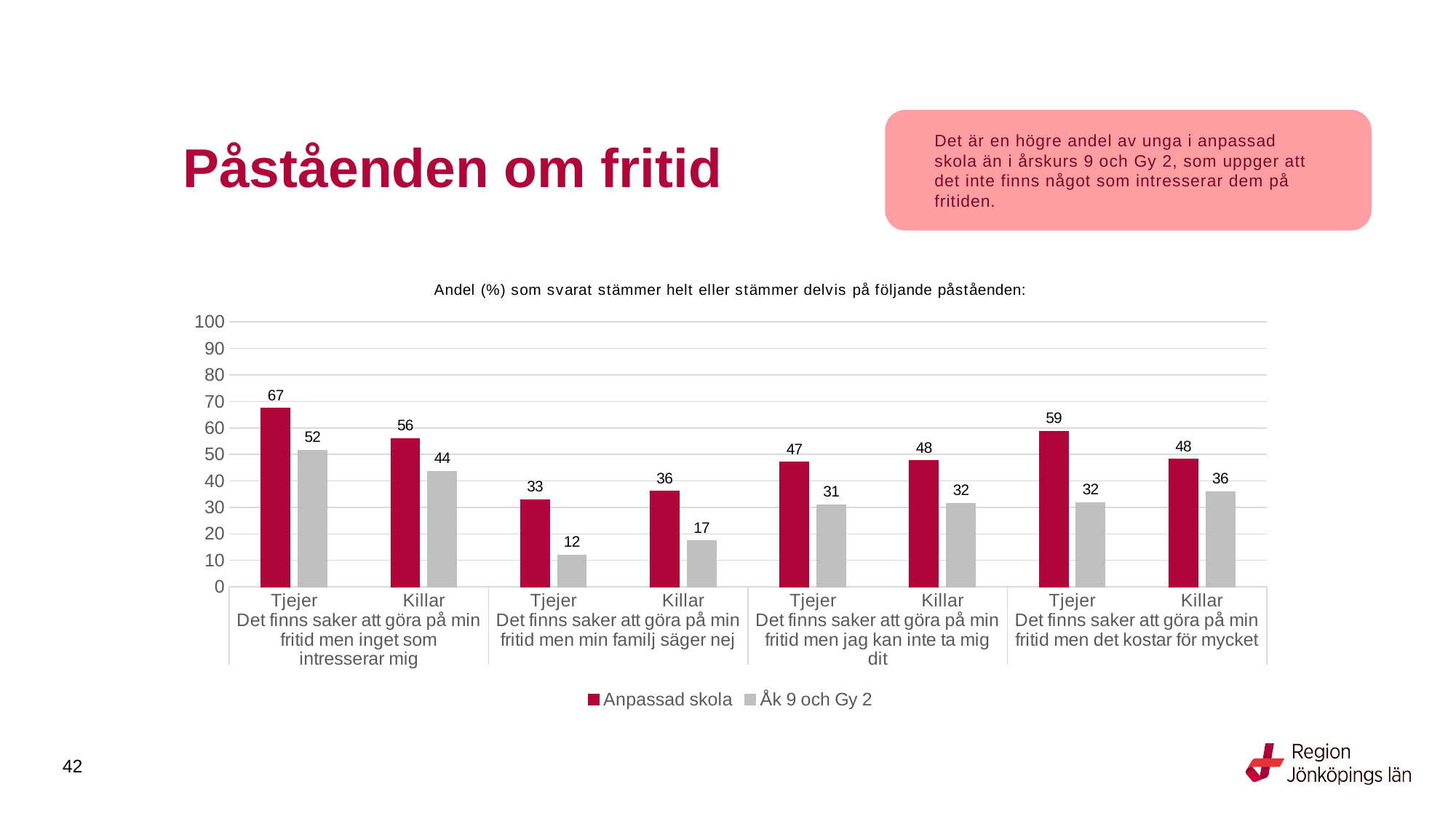
What colour are the bars for the Anpassad skola series? red Which is larger for Killar under 'Det finns saker att göra på min fritid men min familj säger nej': Anpassad skola or Åk 9 och Gy 2? Anpassad skola What is the value for Anpassad skola for Tjejer under 'Det finns saker att göra på min fritid men inget som intresserar mig'? 67 What is the value for Åk 9 och Gy 2 for Killar under 'Det finns saker att göra på min fritid men det kostar för mycket'? 36 What type of chart is shown on the slide? bar chart Which category has the highest value for Anpassad skola? Tjejer, Det finns saker att göra på min fritid men inget som intresserar mig How many bars are plotted for the Anpassad skola series? 8 What is the difference between Anpassad skola and Åk 9 och Gy 2 for Tjejer under 'Det finns saker att göra på min fritid men det kostar för mycket'? 27 Which category has the lowest value for Åk 9 och Gy 2? Tjejer, Det finns saker att göra på min fritid men min familj säger nej How many series does the legend list? 2 Is the value for Anpassad skola for Killar under 'Det finns saker att göra på min fritid men inget som intresserar mig' greater or less than 50? greater What is the value for Åk 9 och Gy 2 for Tjejer under 'Det finns saker att göra på min fritid men min familj säger nej'? 12